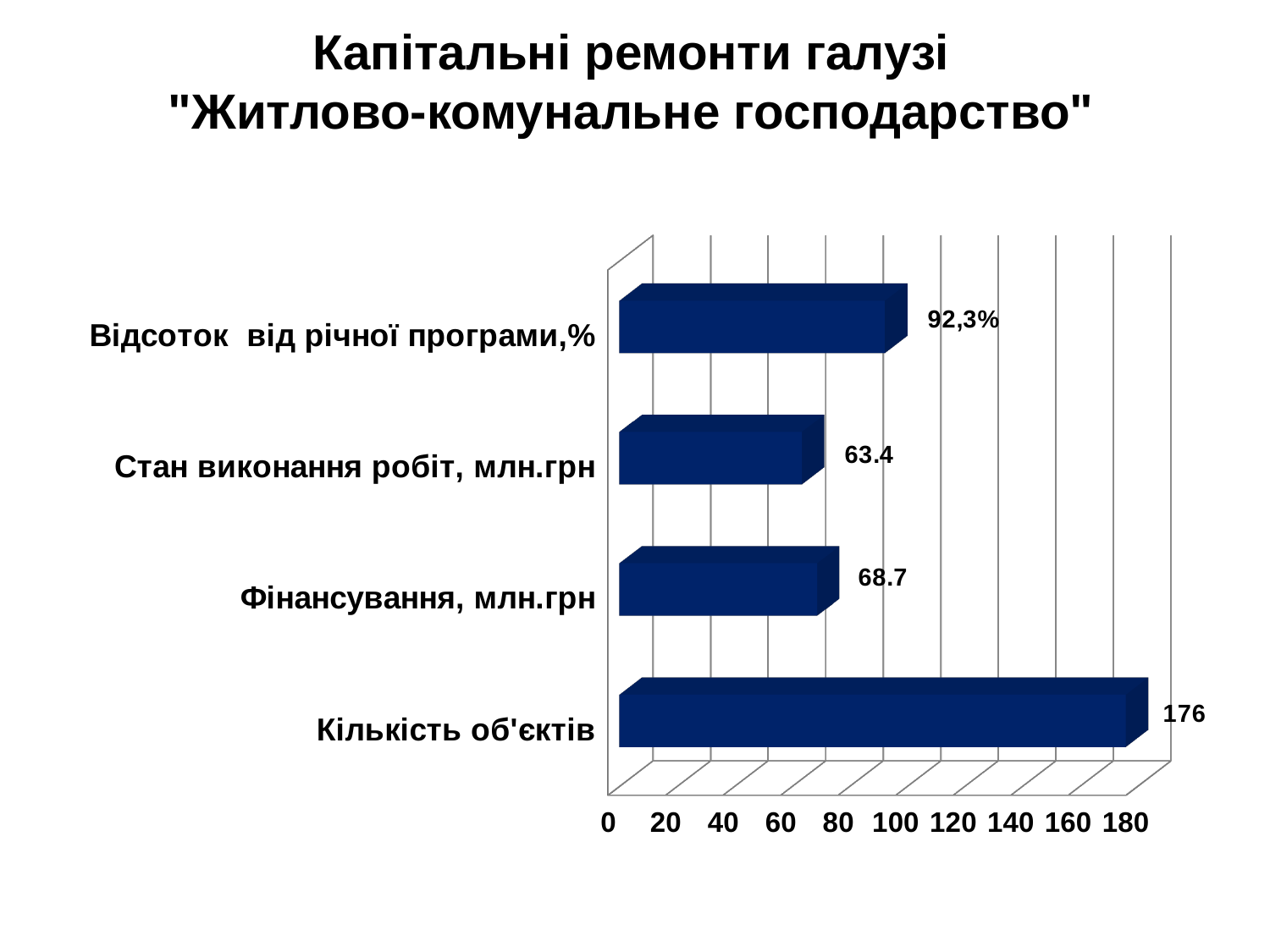
What kind of chart is shown on the slide? bar chart What is the value for "Кількість об'єктів"? 176 Which category has the highest value? Кількість об'єктів What is the difference between "Фінансування, млн.грн" and "Стан виконання робіт, млн.грн"? 5.3 Is the value for "Кількість об'єктів" greater or less than 160? greater What is the value for "Стан виконання робіт, млн.грн"? 63.4 What is the title of the slide? Капітальні ремонти галузі "Житлово-комунальне господарство" Which category has the lowest value? Стан виконання робіт, млн.грн Which is larger: "Фінансування, млн.грн" or "Стан виконання робіт, млн.грн"? Фінансування, млн.грн What is the value shown for "Відсоток від річної програми,%"? 92,3% How many categories are shown in the chart? 4 What is the value for "Фінансування, млн.грн"? 68.7